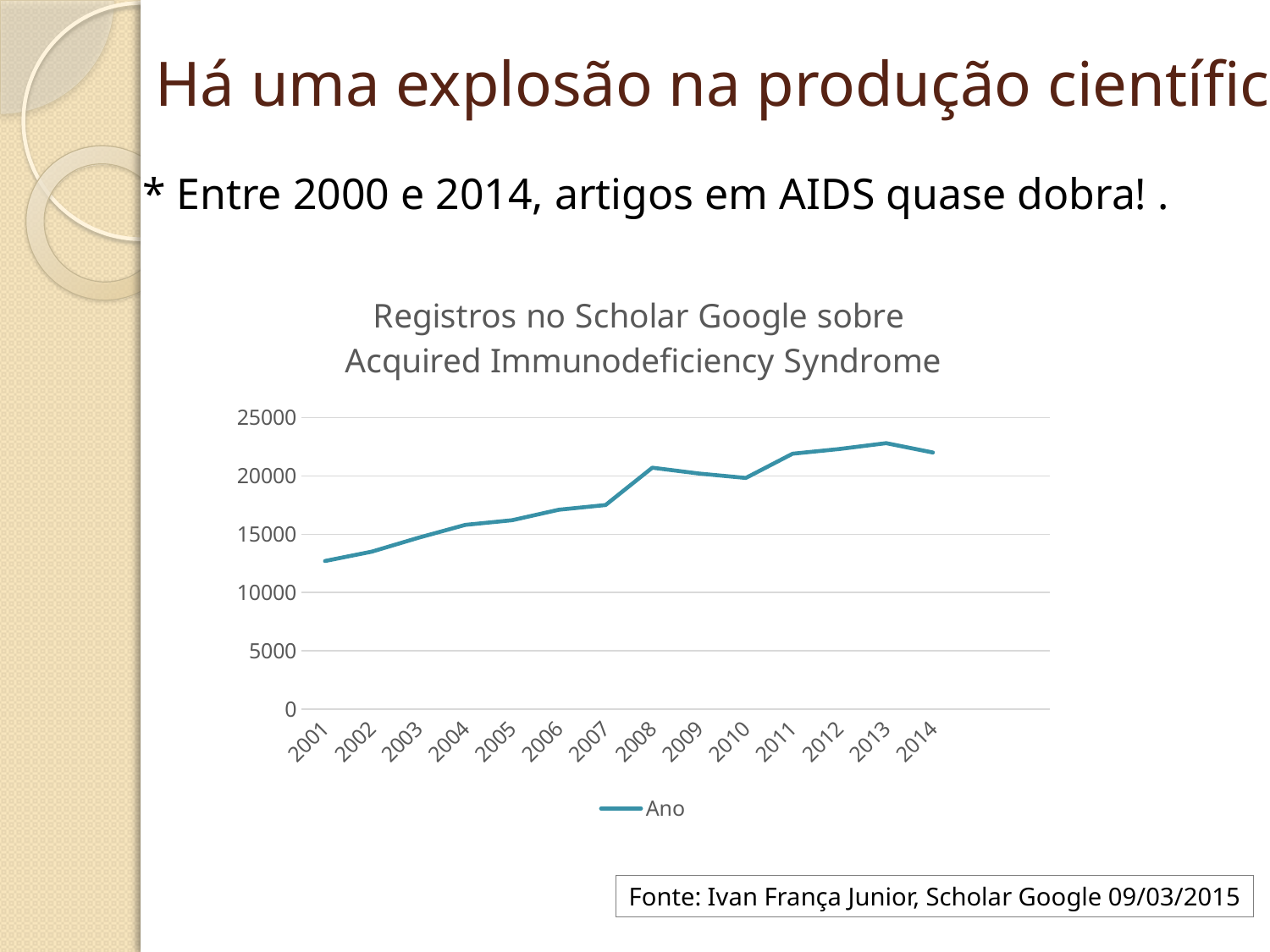
Is the value for 2008 greater or less than 20000? greater What is the title of the chart? Registros no Scholar Google sobre Acquired Immunodeficiency Syndrome Which year has the larger value, 2001 or 2014? 2014 How many series does the chart's legend list? 1 What is the name of the series shown in the chart's legend? Ano Is the value for 2007 greater or less than 20000? less How many years are plotted along the x axis of the chart? 14 Which year has the highest value in the chart? 2013 Do the values generally rise or fall from 2001 to 2014? rise Which year has the lowest value in the chart? 2001 Is the value for 2001 greater or less than 15000? less What kind of chart is shown on the slide? line chart